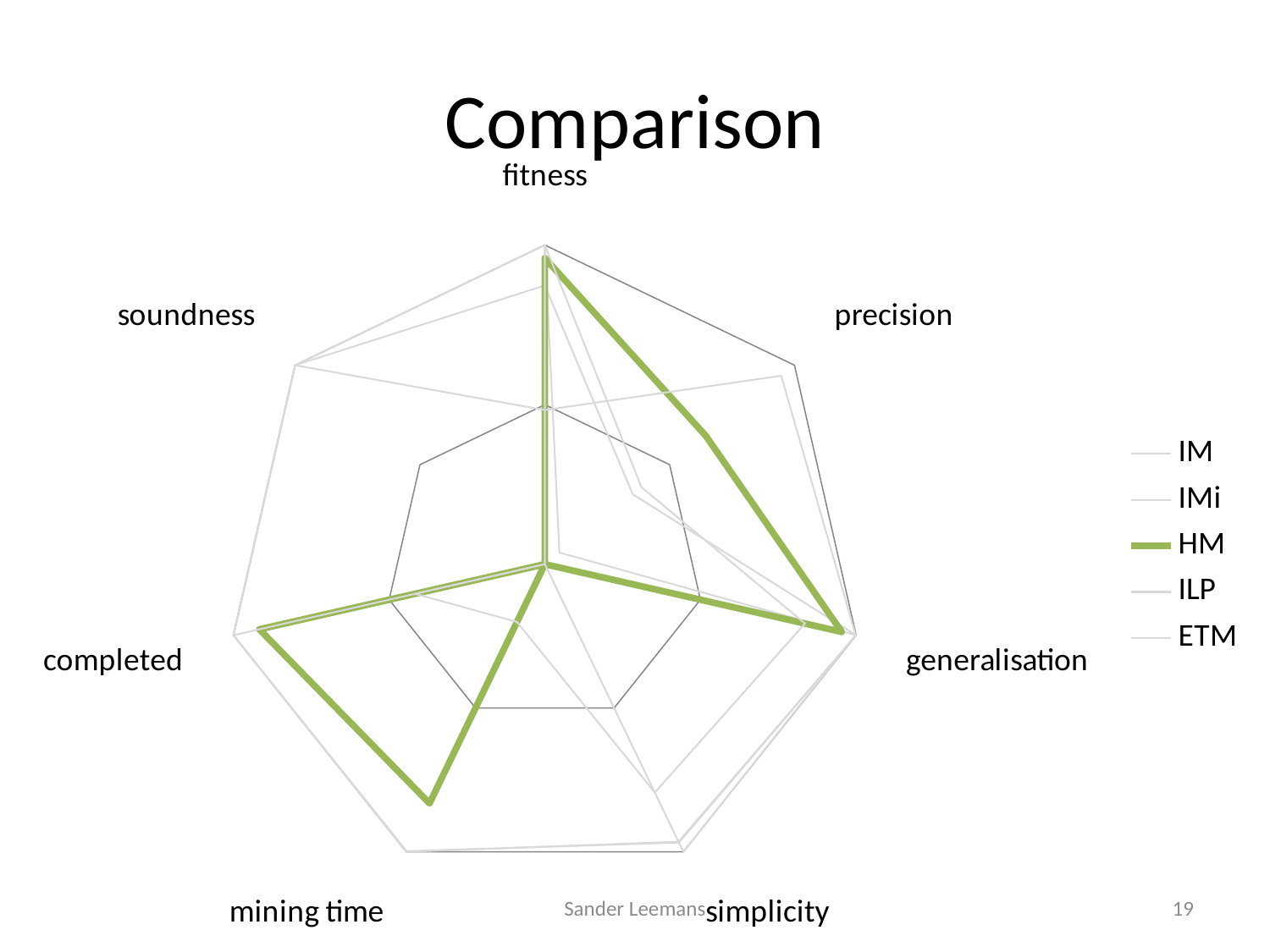
Which series is listed last in the legend? ETM How many axes (categories) does the radar chart have? 7 Which axis is at the top of the radar chart? fitness What is the title of the slide containing the chart? Comparison Which series is listed first in the legend? IM What kind of chart is shown on the slide? Radar chart How many series does the legend list? 5 On which axes does the HM series sit at the centre of the chart? soundness and simplicity Which axis is at the bottom right of the radar chart, next to generalisation? simplicity